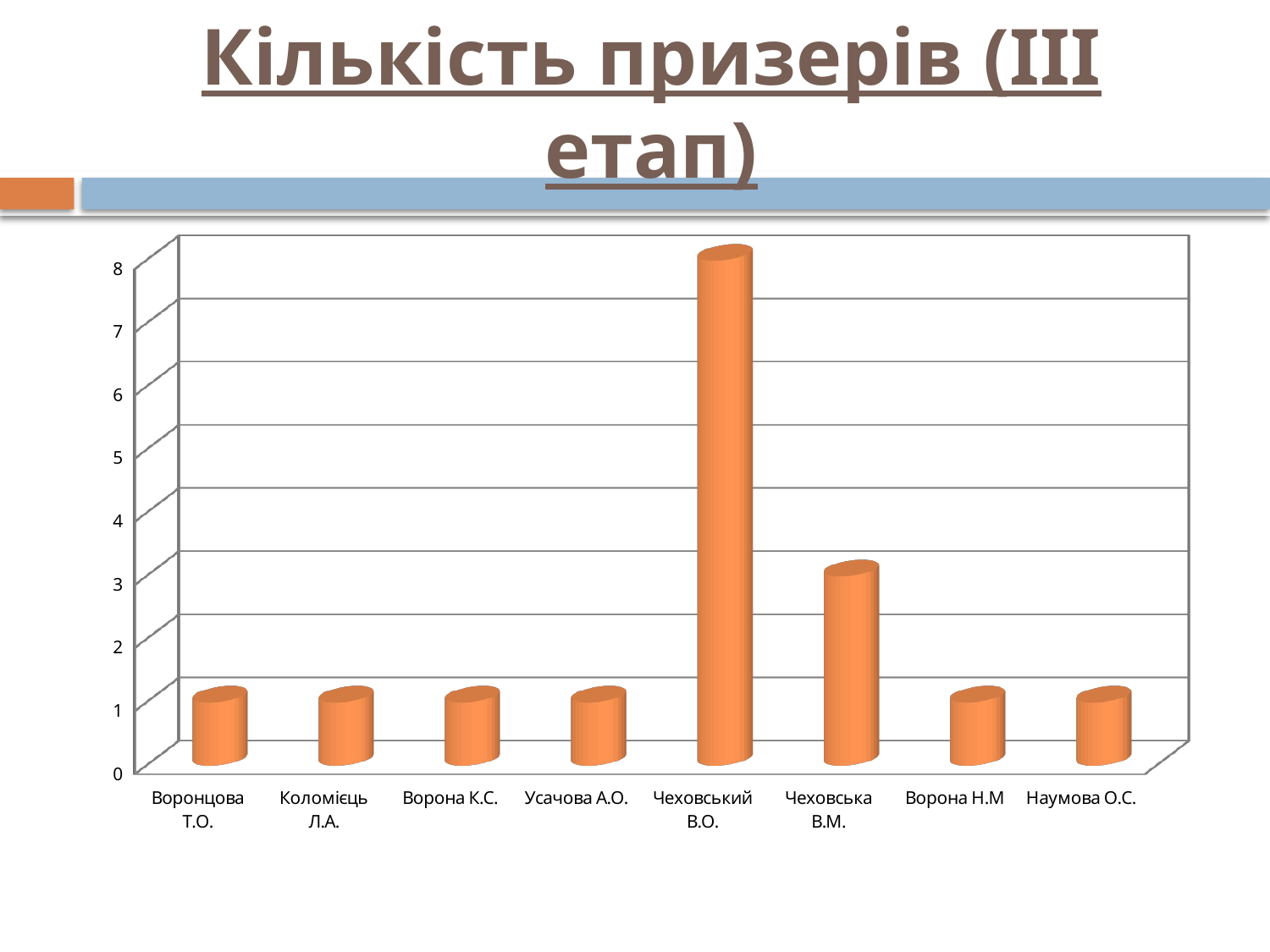
How many categories (people) are shown on the x axis of the chart? 8 What is the value for Воронцова Т.О.? 1 What is the difference between the values for Чеховський В.О. and Чеховська В.М.? 5 What is the value for Чеховський В.О.? 8 Is the value for Ворона К.С. greater or less than 2? less What is the title of the slide containing the chart? Кількість призерів (ІІІ етап) Is the value for Чеховський В.О. greater or less than 5? greater What is the highest value shown on the vertical axis of the chart? 8 What kind of chart is shown on the slide? bar chart What is the value for Чеховська В.М.? 3 Which is larger, the value for Чеховська В.М. or the value for Наумова О.С.? Чеховська В.М. Which category has the highest value in the chart? Чеховський В.О.